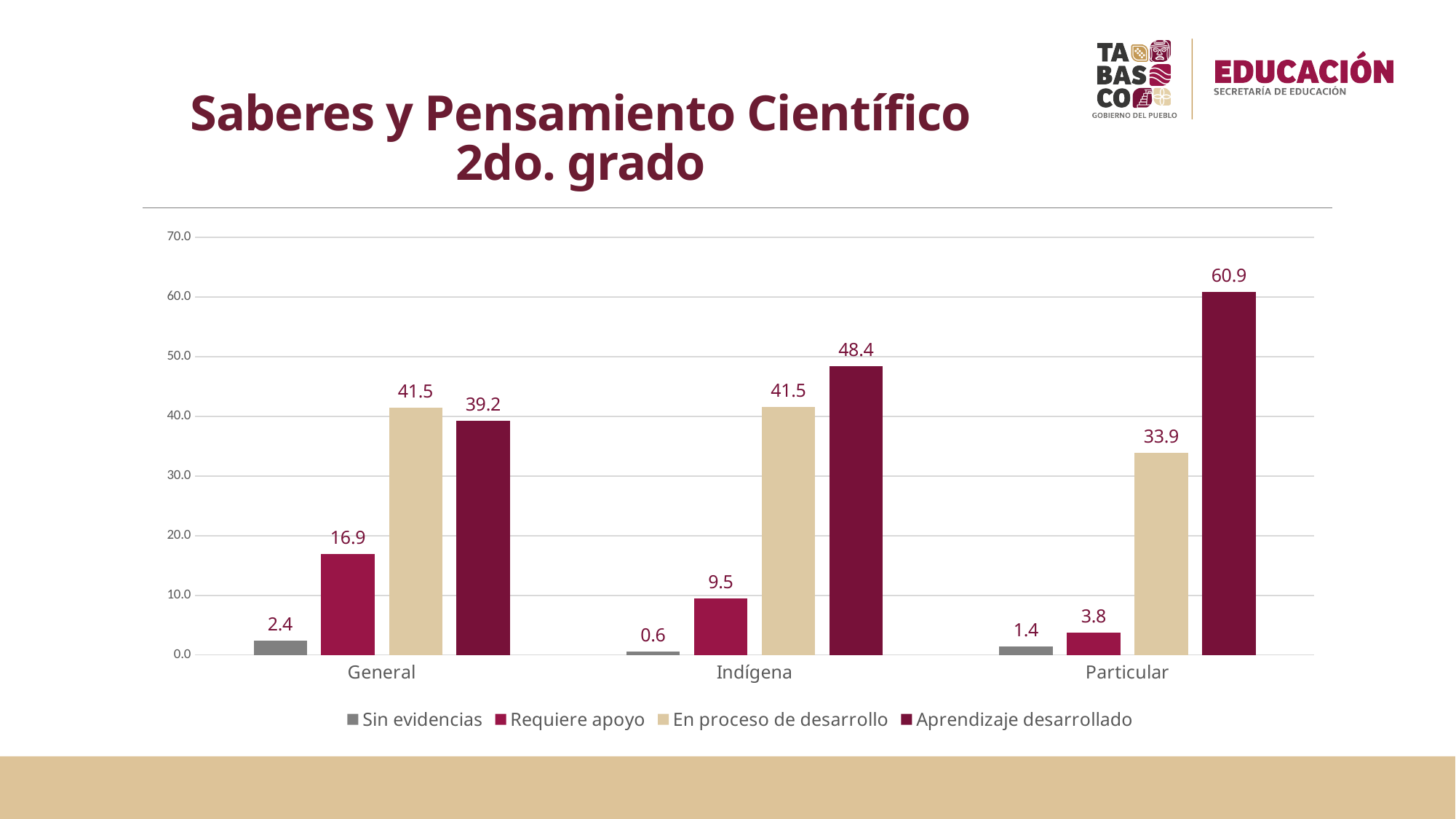
What is the value for En proceso de desarrollo in the Particular category? 33.9 How many categories are shown on the x axis? 3 What kind of chart is shown on the slide? Bar chart How many series does the legend list? 4 What is the value for Aprendizaje desarrollado in the Particular category? 60.9 What is the value for Sin evidencias in the Indígena category? 0.6 What is the title of the slide? Saberes y Pensamiento Científico 2do. grado Which category has the lowest value for Sin evidencias? Indígena Which is larger in the Indígena category: En proceso de desarrollo or Aprendizaje desarrollado? Aprendizaje desarrollado What is the difference between Aprendizaje desarrollado in Particular and in General? 21.7 Which category has the highest value for Aprendizaje desarrollado? Particular What is the value for Requiere apoyo in the General category? 16.9